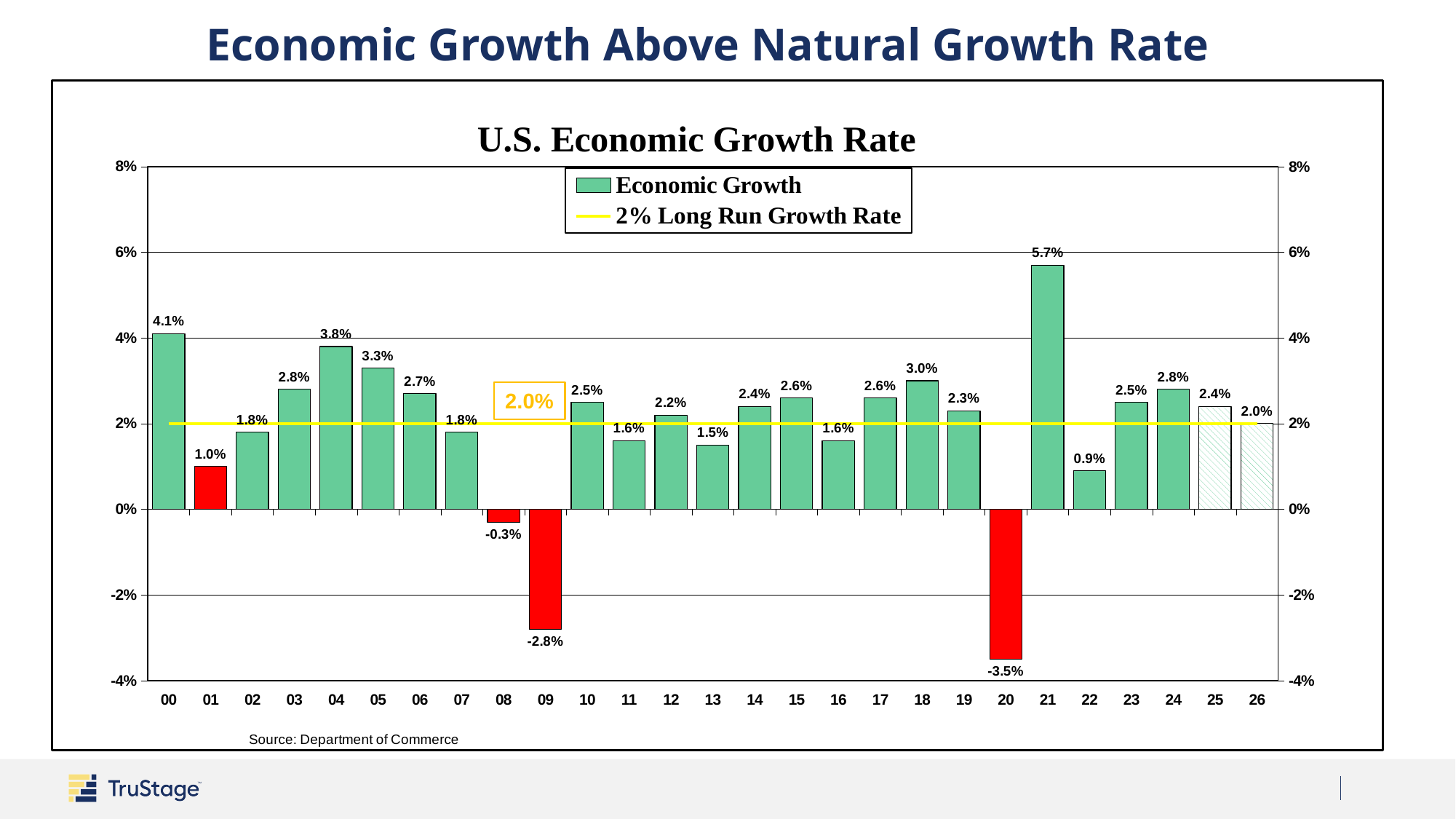
Which year has the lowest economic growth rate? 20 What kind of chart is used to show the economic growth rate? bar chart Is the economic growth rate for 00 greater or less than 4%? greater Which year has the highest economic growth rate? 21 What is the economic growth rate shown for 21? 5.7% How many years are shown on the x axis? 27 How many entries does the legend list? 2 What is the title of the chart? U.S. Economic Growth Rate What is the economic growth rate shown for 09? -2.8% What is the economic growth rate shown for 25? 2.4% Which year has a higher economic growth rate, 04 or 18? 04 What is the difference between the economic growth rate in 21 and in 22? 4.8%